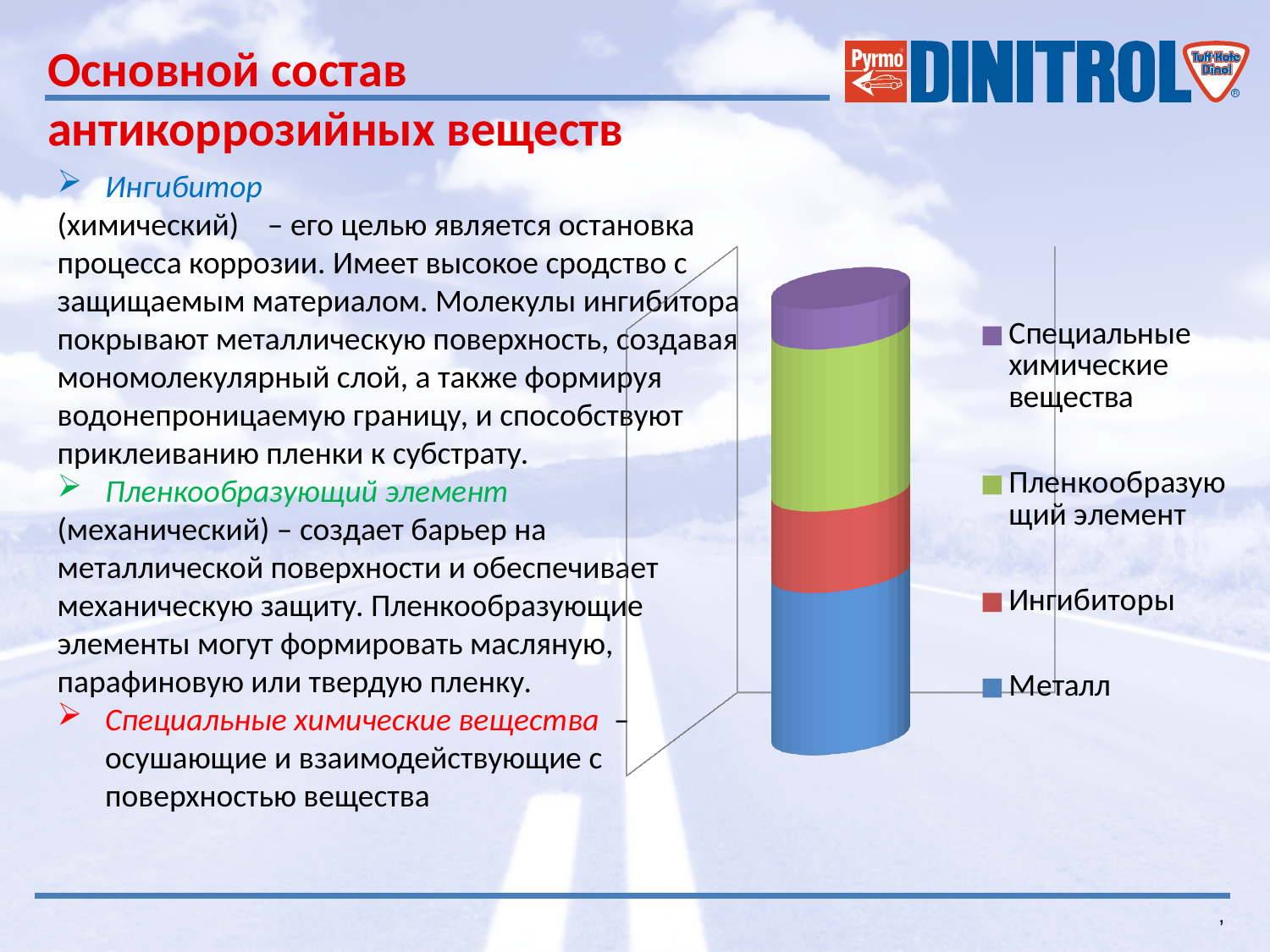
How many series does the chart legend list? 4 What kind of chart is shown on the slide? stacked bar chart In the stacked bar, which segment is larger: "Пленкообразующий элемент" or "Ингибиторы"? Пленкообразующий элемент In the stacked bar, which segment is larger: "Пленкообразующий элемент" or "Специальные химические вещества"? Пленкообразующий элемент Which legend entry is shown in purple? Специальные химические вещества Which series is listed last (at the bottom) in the chart legend? Металл In the stacked bar, which segment is larger: "Металл" or "Специальные химические вещества"? Металл Which colour represents the series "Металл" in the chart? blue How many bars are plotted in the chart? 1